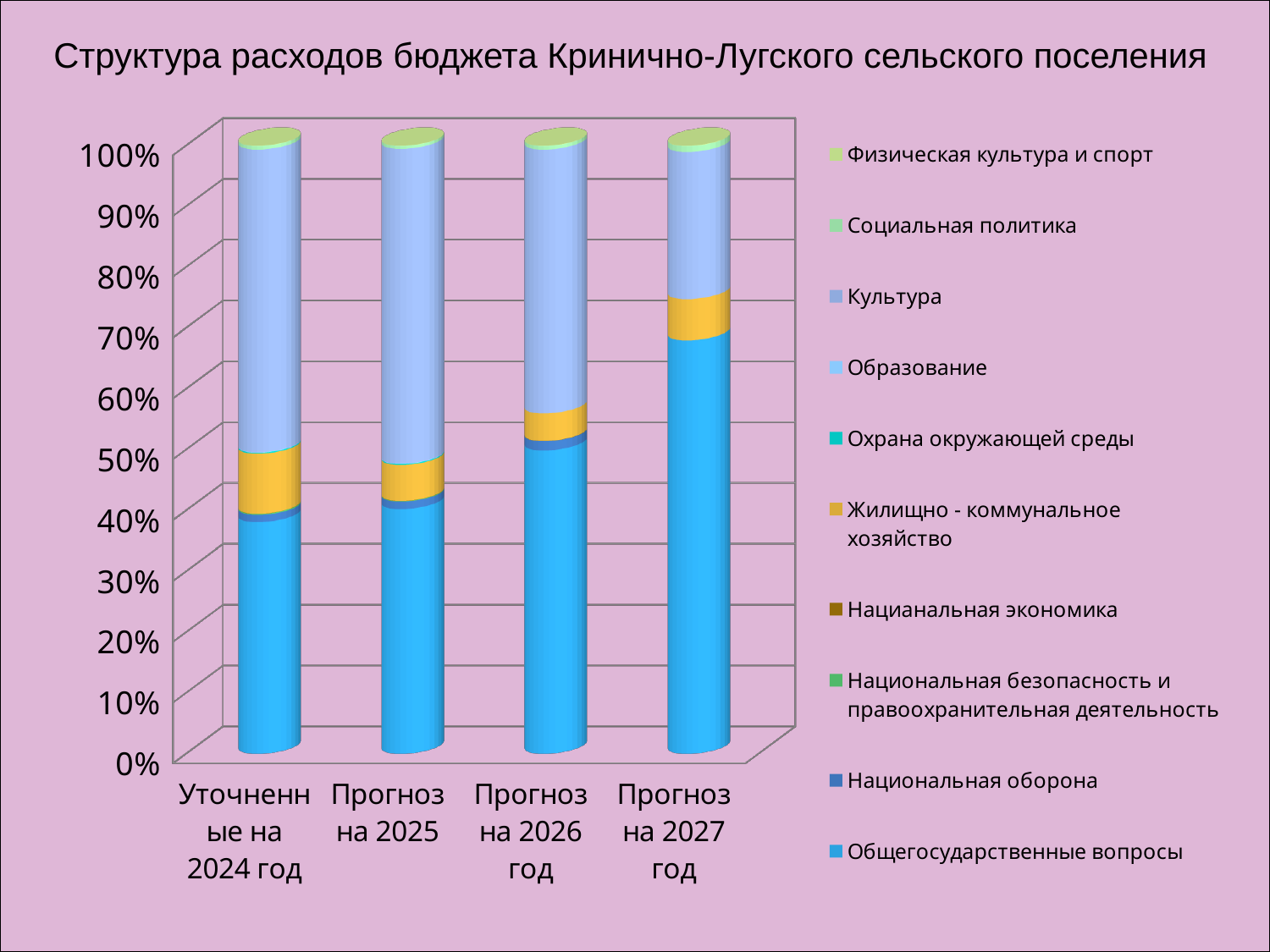
What is the title of the chart? Структура расходов бюджета Кринично-Лугского сельского поселения Which bar has the largest share of Общегосударственные вопросы? Прогноз на 2027 год Is the share of Общегосударственные вопросы for Прогноз на 2026 год greater or less than 40%? greater Is the share of Культура larger for Уточненные на 2024 год or for Прогноз на 2027 год? Уточненные на 2024 год Is the share of Общегосударственные вопросы for Прогноз на 2027 год greater or less than 60%? greater Is the share of Жилищно - коммунальное хозяйство larger for Уточненные на 2024 год or for Прогноз на 2026 год? Уточненные на 2024 год What kind of chart is shown on the slide? Stacked bar chart How many bars (budget periods) are plotted on the chart? 4 Does the share of Общегосударственные вопросы rise or fall from 2024 to 2027 along the x axis? rise Which legend entry is shown at the bottom of the legend? Общегосударственные вопросы How many series does the legend list? 10 Is the share of Общегосударственные вопросы for Уточненные на 2024 год greater or less than 50%? less